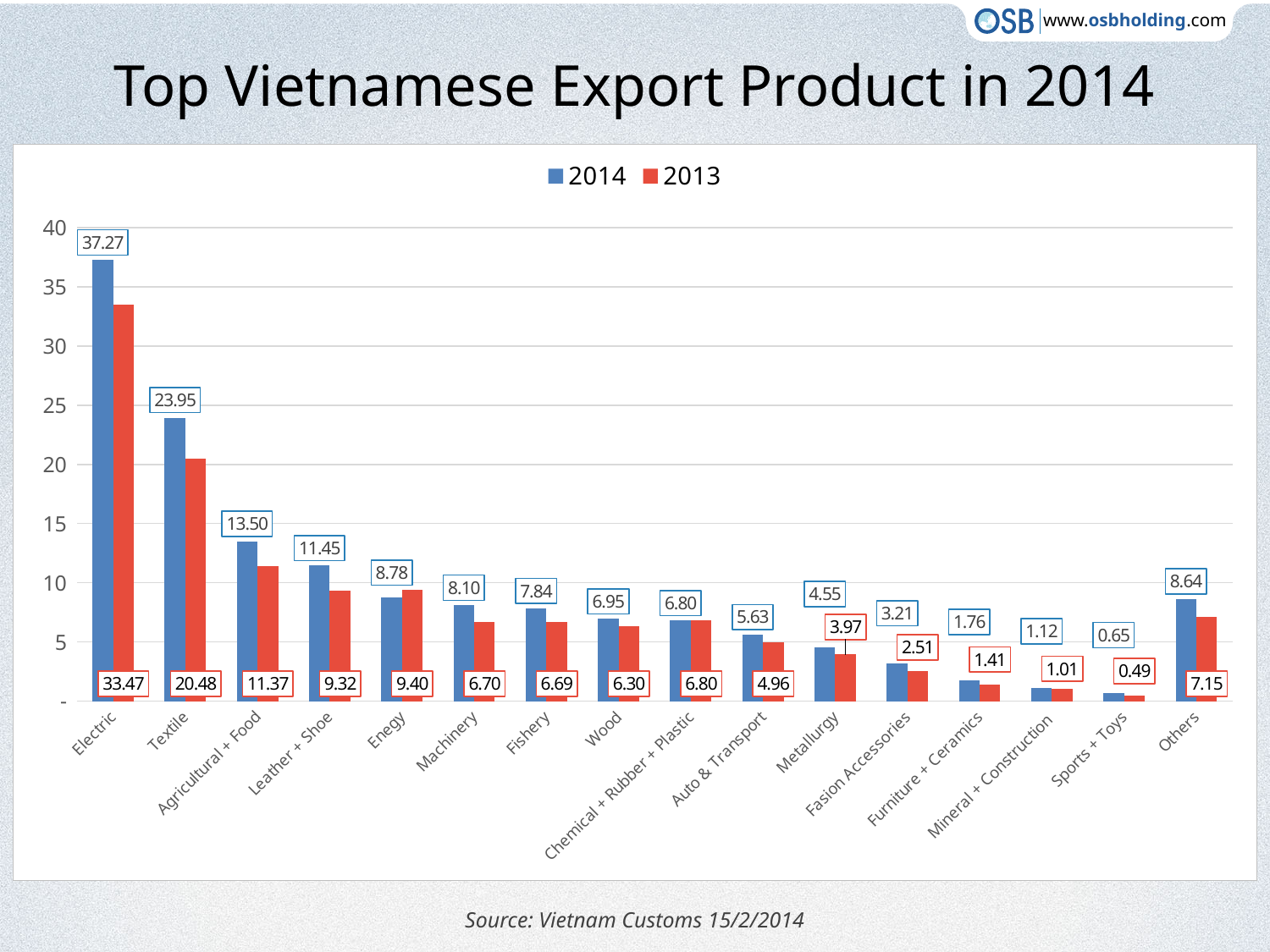
Which category has the lowest 2013 value? Sports + Toys What is the 2013 value for Textile? 20.48 Which has the larger 2014 value, Wood or Machinery? Machinery Which category has the highest 2014 value? Electric What is the difference between the 2014 and 2013 values for Textile? 3.47 How many series does the legend list? 2 What is the 2014 value for Electric? 37.27 What is the 2014 value for Others? 8.64 For Enegy, which year has the larger value, 2014 or 2013? 2013 What kind of chart is shown on the slide? Bar chart How many categories are shown on the x axis? 16 What is the difference between the 2014 and 2013 values for Electric? 3.80